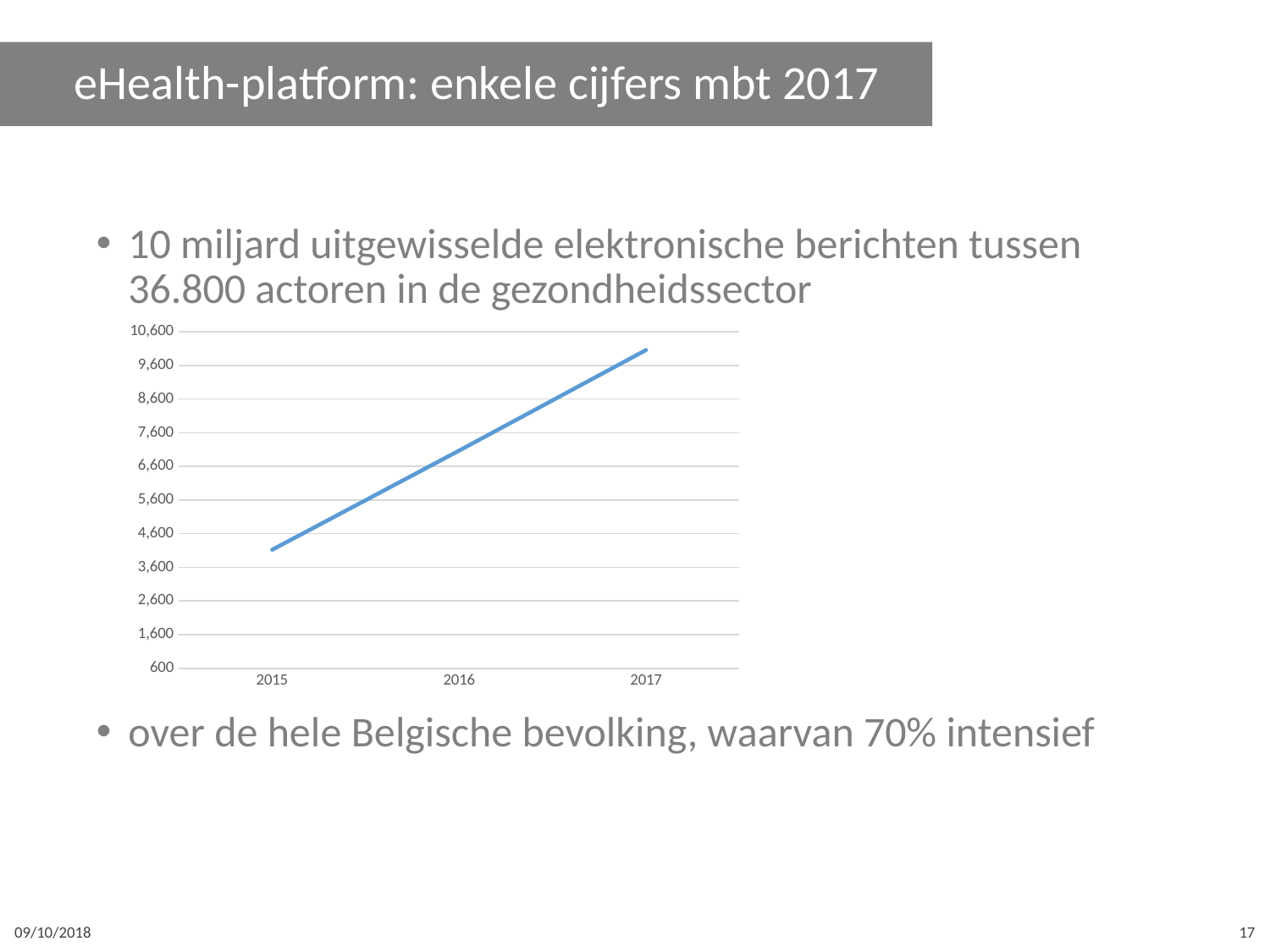
What kind of chart is shown on the slide? line chart Do the values in the chart rise or fall from 2015 to 2017? rise Is the value for 2016 greater or less than 5,600? greater Which year has the highest value in the chart? 2017 Which is larger, the value for 2015 or the value for 2017? 2017 How many years are shown on the x axis of the chart? 3 Is the value for 2015 greater or less than 3,600? greater Which year has the lowest value in the chart? 2015 Is the value for 2015 greater or less than 4,600? less What is the highest tick label on the y axis of the chart? 10,600 What colour is the line in the chart? blue